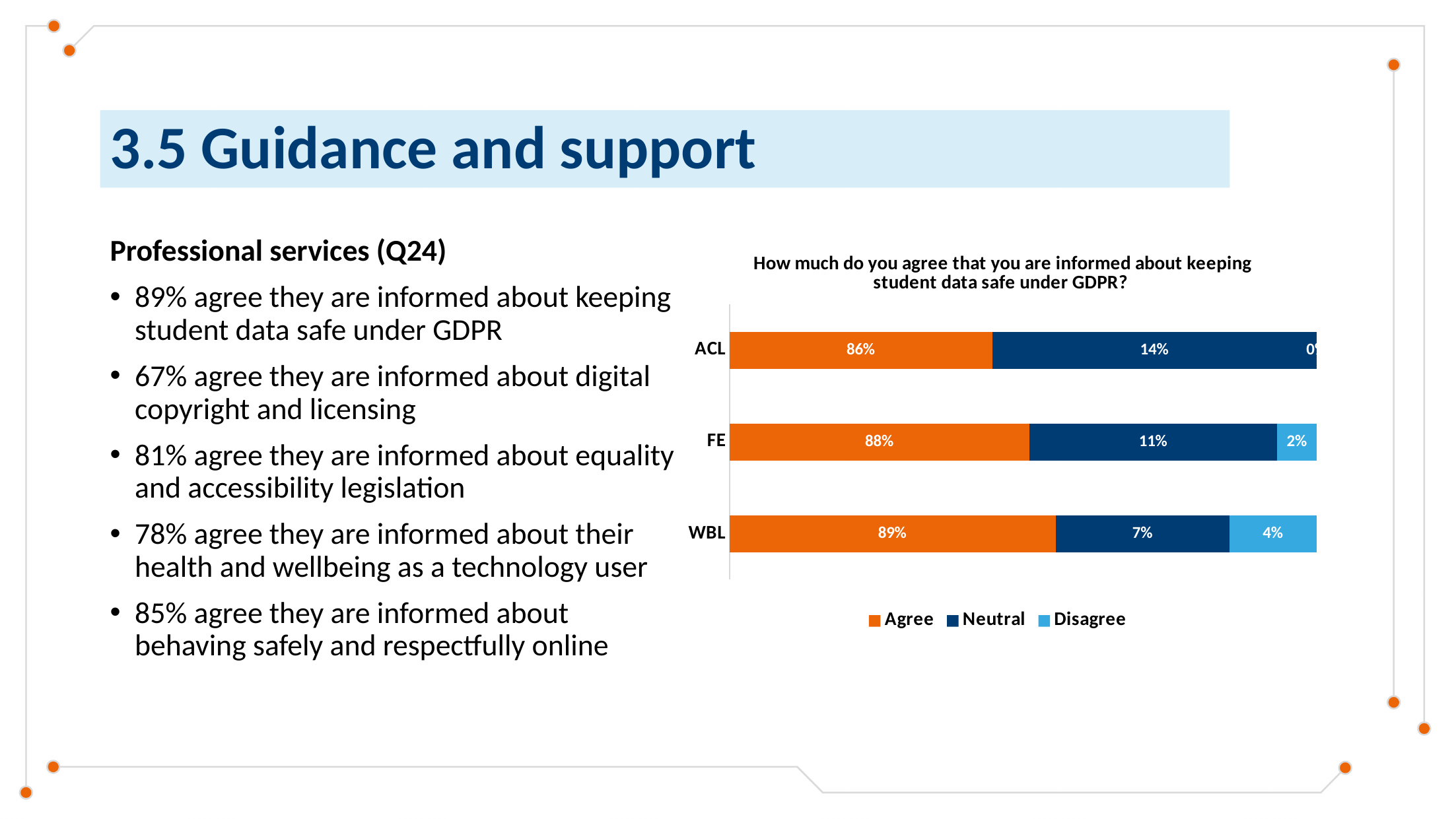
What percentage of ACL respondents agree that they are informed about keeping student data safe under GDPR? 86% What is the Neutral value for FE in the chart? 11% Which has a larger Neutral percentage, ACL or FE? ACL Which series is shown in orange in the chart? Agree What kind of chart is shown on the slide? Stacked bar chart How many series does the legend list? 3 How many categories are shown on the chart? 3 Which category has the lowest Neutral percentage? WBL What is the difference between the Agree percentages for WBL and ACL? 3% What is the Neutral value for WBL? 7% Which category has the highest Agree percentage? WBL What percentage of WBL respondents disagree? 4%